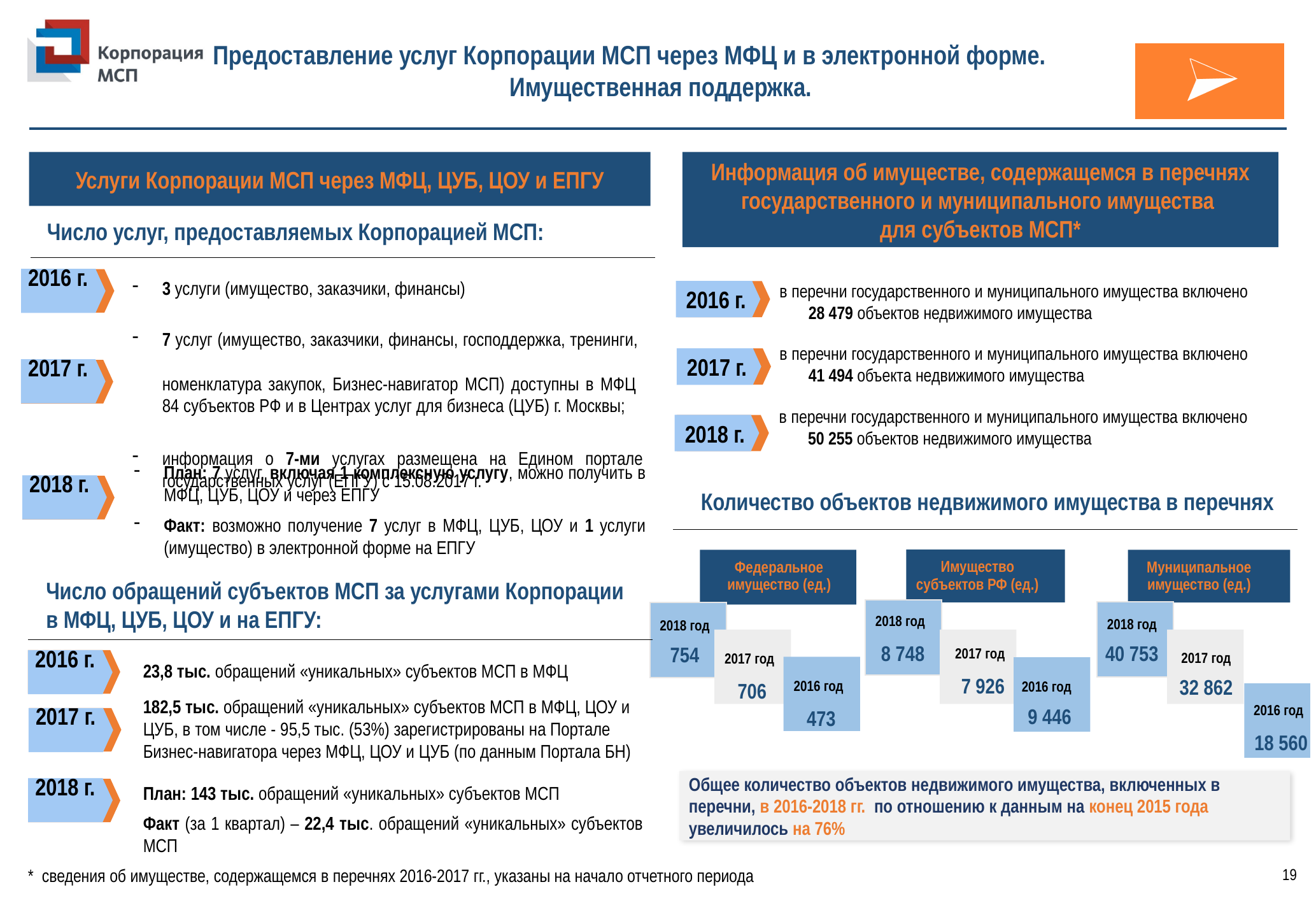
In the chart 'Количество объектов недвижимого имущества в перечнях', how many property categories are shown? 3 In the chart 'Количество объектов недвижимого имущества в перечнях', what is the value for Имущество субъектов РФ in 2016? 9 446 In the chart 'Количество объектов недвижимого имущества в перечнях', what is the difference between the 2018 and 2017 values for Муниципальное имущество? 7 891 In the chart 'Количество объектов недвижимого имущества в перечнях', which is larger for Имущество субъектов РФ: the 2016 value or the 2018 value? 2016 In the chart 'Количество объектов недвижимого имущества в перечнях', how many years are shown for each property category? 3 In the chart 'Количество объектов недвижимого имущества в перечнях', which property category has the lowest value in 2017? Федеральное имущество In the chart 'Количество объектов недвижимого имущества в перечнях', which property category has the highest value in 2018? Муниципальное имущество In the chart 'Количество объектов недвижимого имущества в перечнях', what is the value for Федеральное имущество in 2016? 473 In the chart 'Количество объектов недвижимого имущества в перечнях', what is the difference between the 2018 and 2016 values for Федеральное имущество? 281 In the chart 'Количество объектов недвижимого имущества в перечнях', what is the value for Муниципальное имущество in 2017? 32 862 In the chart 'Количество объектов недвижимого имущества в перечнях', what is the value for Федеральное имущество in 2018? 754 In the chart 'Количество объектов недвижимого имущества в перечнях', do the values for Муниципальное имущество rise or fall from 2016 to 2018? rise